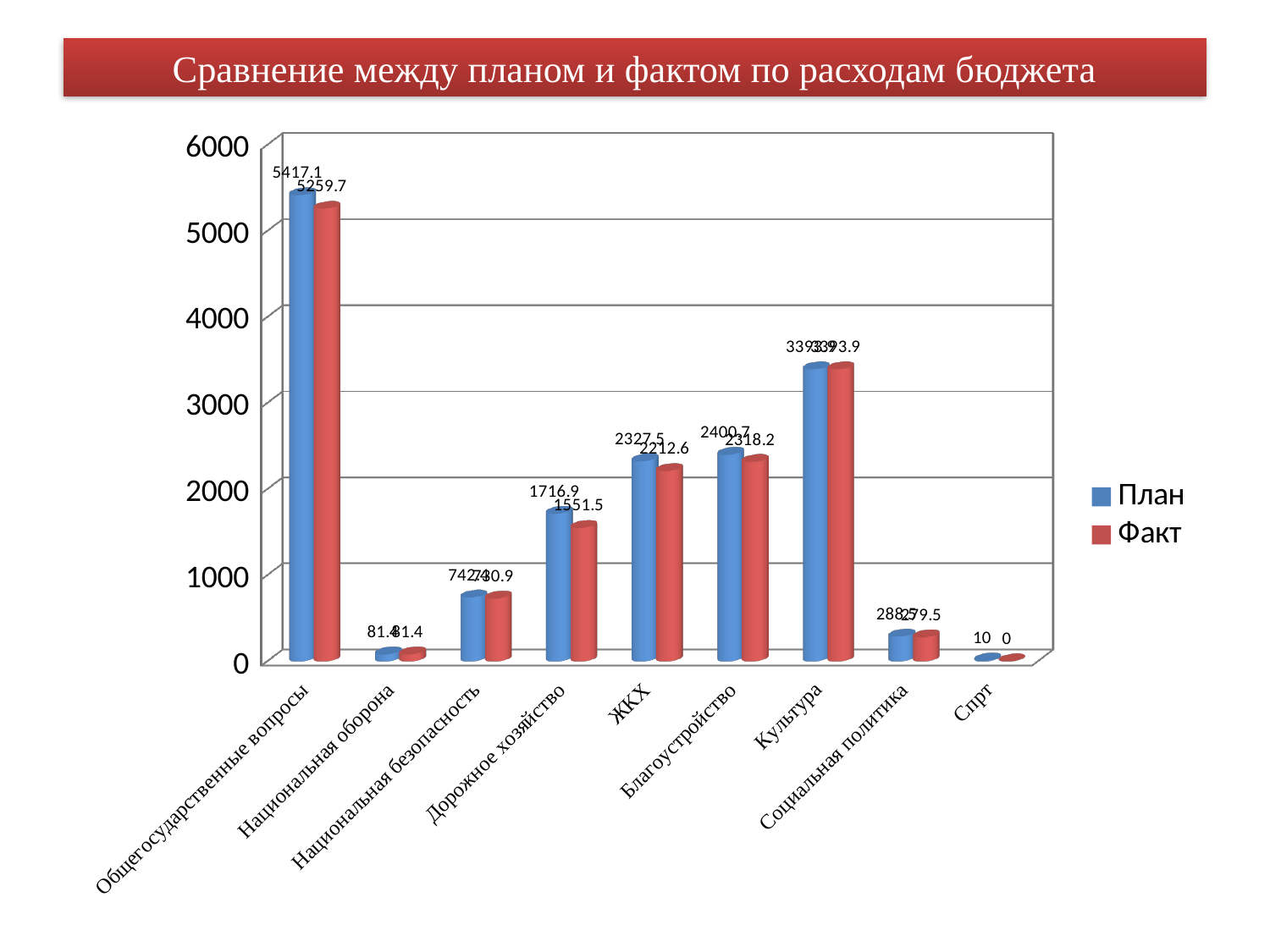
How many categories are shown on the x axis? 9 Which category has the lowest Факт value? Спрт What is the План value for Общегосударственные вопросы? 5417.1 What kind of chart is shown on the slide? bar chart For Благоустройство, which is larger: План or Факт? План What is the difference between План and Факт for ЖКХ? 114.9 What is the Факт value for Дорожное хозяйство? 1551.5 What is the Факт value for Спрт? 0 How many series does the legend list? 2 Which category has the highest План value? Общегосударственные вопросы What is the difference between План and Факт for Общегосударственные вопросы? 157.4 Is the План value for Культура greater or less than 3000? greater